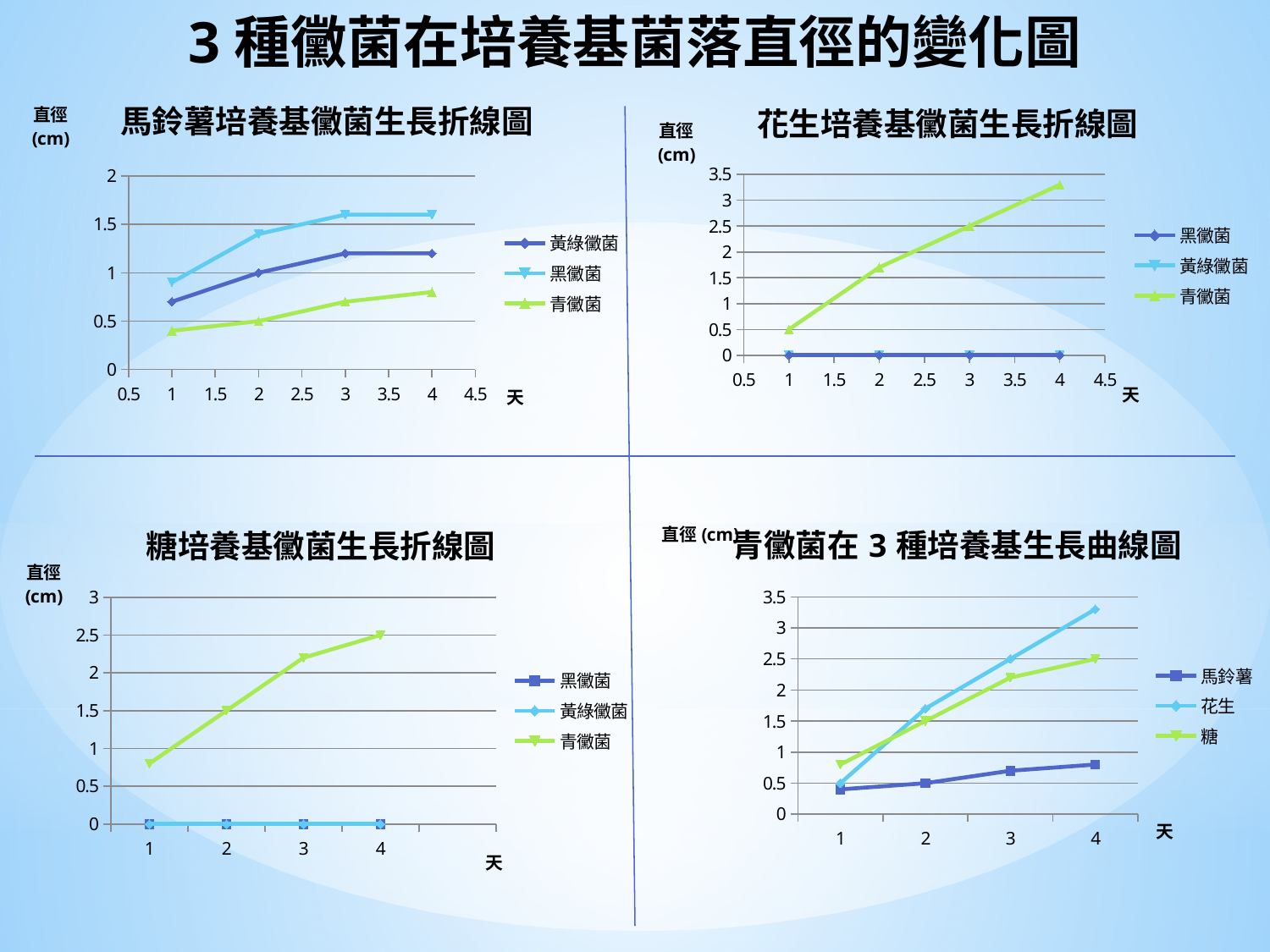
In the 青黴菌在 3 種培養基生長曲線圖 chart, how many days are plotted on the x axis? 4 In the 糖培養基黴菌生長折線圖 chart, does the 青黴菌 line rise or fall from day 1 to day 4? rise In the 馬鈴薯培養基黴菌生長折線圖 chart, which series has the highest value on day 4? 黑黴菌 In the 花生培養基黴菌生長折線圖 chart, what is the value for 黑黴菌 on day 2? 0 In the 青黴菌在 3 種培養基生長曲線圖 chart, which is larger on day 4, 花生 or 糖? 花生 In the 青黴菌在 3 種培養基生長曲線圖 chart, which series has the lowest value on day 4? 馬鈴薯 In the 花生培養基黴菌生長折線圖 chart, is the value for 青黴菌 on day 4 greater or less than 3? greater In the 馬鈴薯培養基黴菌生長折線圖 chart, what is the value for 黃綠黴菌 on day 2? 1 What kind of chart is the 馬鈴薯培養基黴菌生長折線圖 chart? line chart How many series does the legend of the 花生培養基黴菌生長折線圖 chart list? 3 In the 花生培養基黴菌生長折線圖 chart, what is the value for 青黴菌 on day 3? 2.5 In the 糖培養基黴菌生長折線圖 chart, what is the value for 青黴菌 on day 4? 2.5